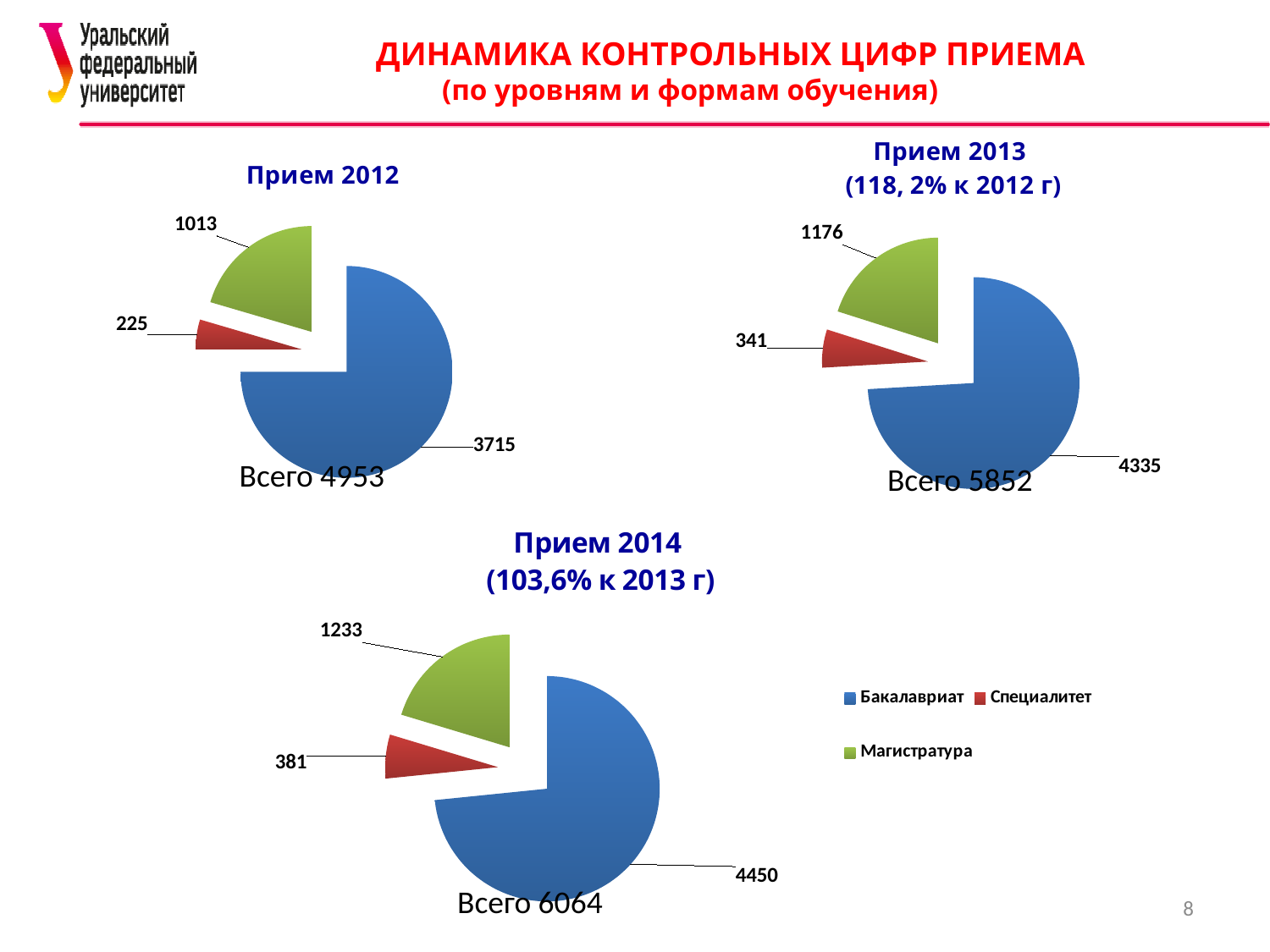
What type of chart is used for Прием 2012? pie chart In the Прием 2012 chart, which category has the smallest slice? Специалитет In the Прием 2012 chart, what is the value for Бакалавриат? 3715 What is the difference between the Бакалавриат value in the Прием 2014 chart and the Бакалавриат value in the Прием 2013 chart? 115 In the Прием 2014 chart, which category has the largest slice? Бакалавриат In the Прием 2013 chart, what is the value for Специалитет? 341 How many series does the legend list? 3 What total (Всего) is shown under the Прием 2013 chart? Всего 5852 Which is larger: the Специалитет value in the Прием 2013 chart or the Специалитет value in the Прием 2014 chart? Прием 2014 In the Прием 2014 chart, what is the value for Магистратура? 1233 What is the difference between the Магистратура value in the Прием 2013 chart and the Магистратура value in the Прием 2012 chart? 163 How many slices does the Прием 2013 pie chart have? 3